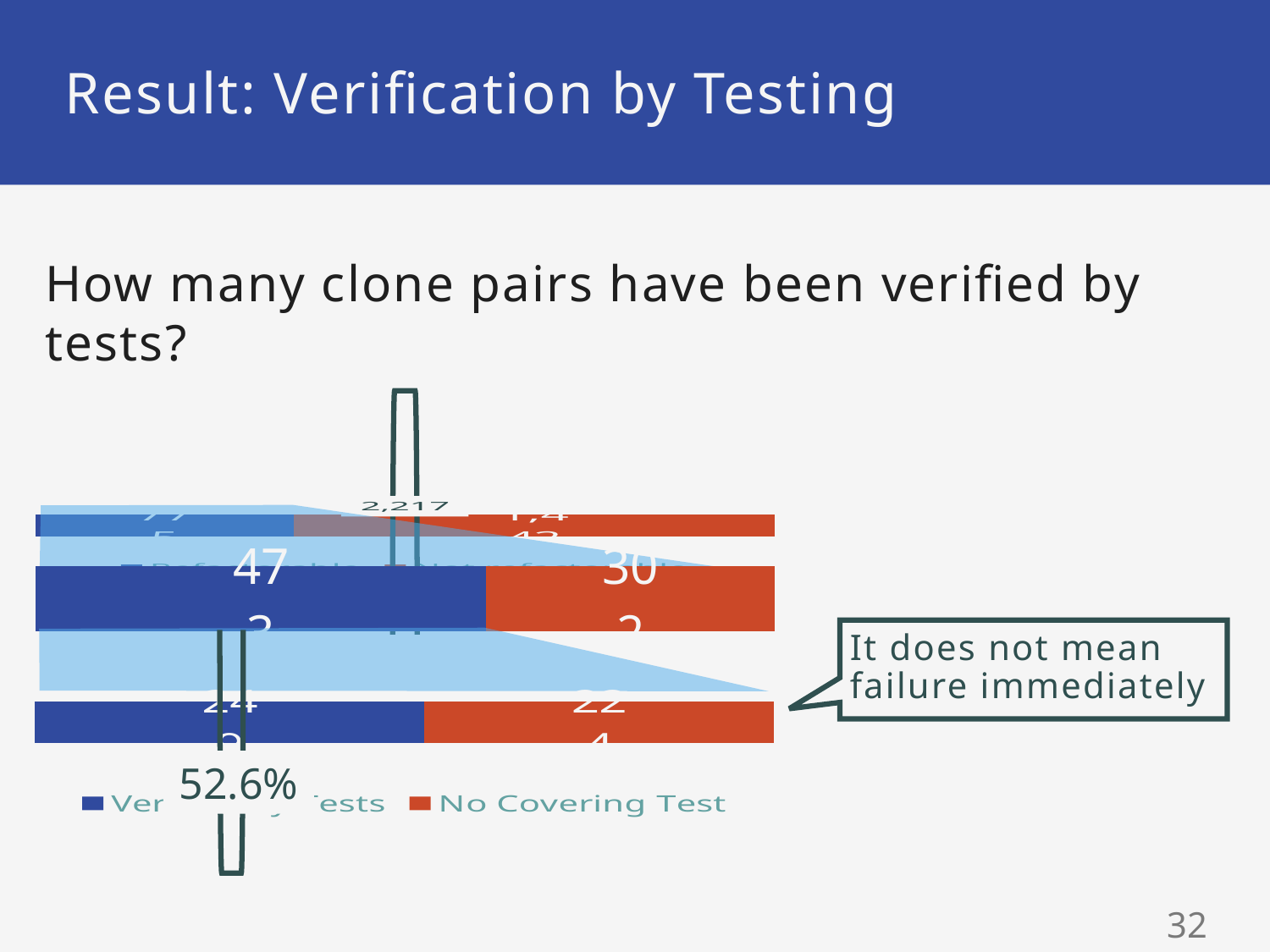
How many series does the legend of the stacked bar chart list? 2 What kind of chart is shown on the slide? bar chart How many stacked bars are plotted in the chart? 3 In the middle bar, which segment is larger, the blue one or the red one? blue What percentage is printed in large text below the bottom bar? 52.6% Which legend entry is shown in red? No Covering Test